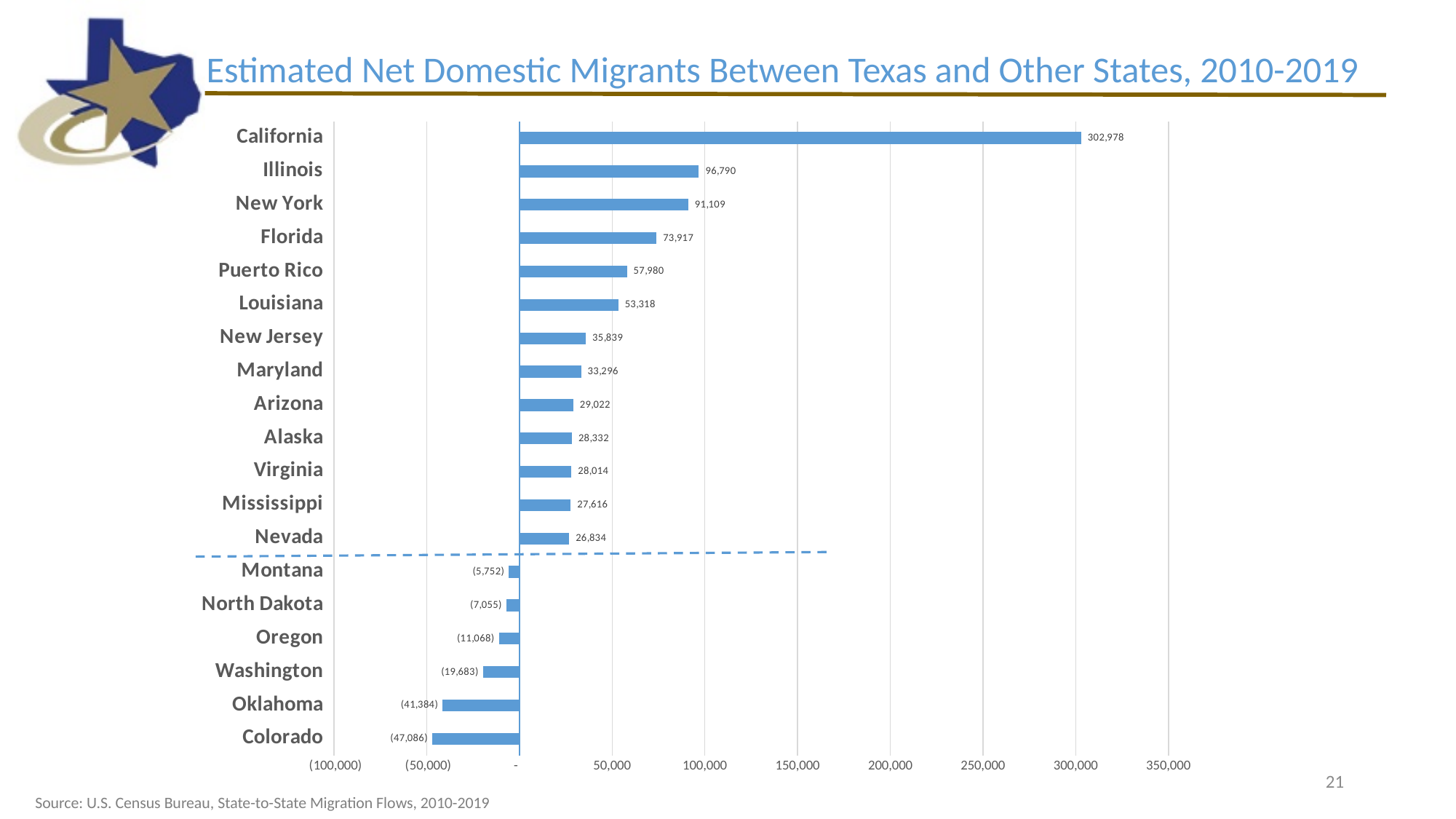
Which state has the highest value? California Which has a larger value, Florida or Louisiana? Florida What is the value for California? 302,978 What is the title of the chart? Estimated Net Domestic Migrants Between Texas and Other States, 2010-2019 What is the difference between the values for Illinois and New York? 5,681 What is the value for Puerto Rico? 57,980 What kind of chart is shown on the slide? bar chart What is the value for Colorado? (47,086) Which state has the lowest value? Colorado How many states have negative values on the chart? 6 Is the value for New Jersey greater or less than 50,000? less How many states or territories are shown on the chart? 19